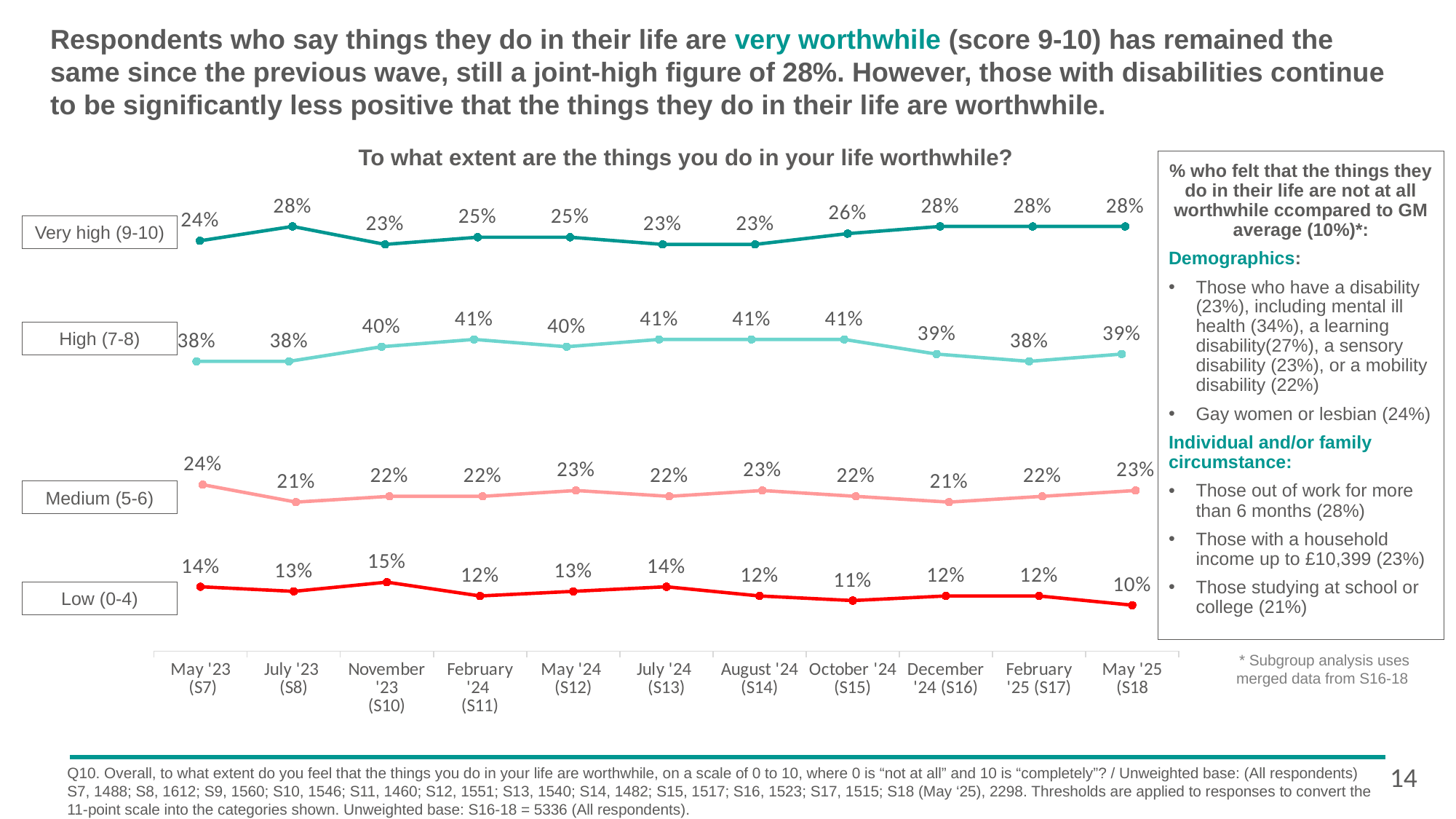
How many survey waves are plotted along the x axis? 11 In which wave is the Low (0-4) series at its lowest? May '25 (S18) In which wave is the Low (0-4) series at its highest? November '23 (S10) Which wave has the larger Very high (9-10) value, May '23 (S7) or July '23 (S8)? July '23 (S8) What is the value for Very high (9-10) in May '25 (S18)? 28% Does the Very high (9-10) series rise or fall from July '24 (S13) to December '24 (S16)? Rise In May '25 (S18), how many percentage points higher is High (7-8) than Very high (9-10)? 11 percentage points What is the value for High (7-8) in February '24 (S11)? 41% How many series are shown on the chart? 4 What is the value for Medium (5-6) in May '23 (S7)? 24% What type of chart is used on this slide? Line chart What is the value for Low (0-4) in May '25 (S18)? 10%